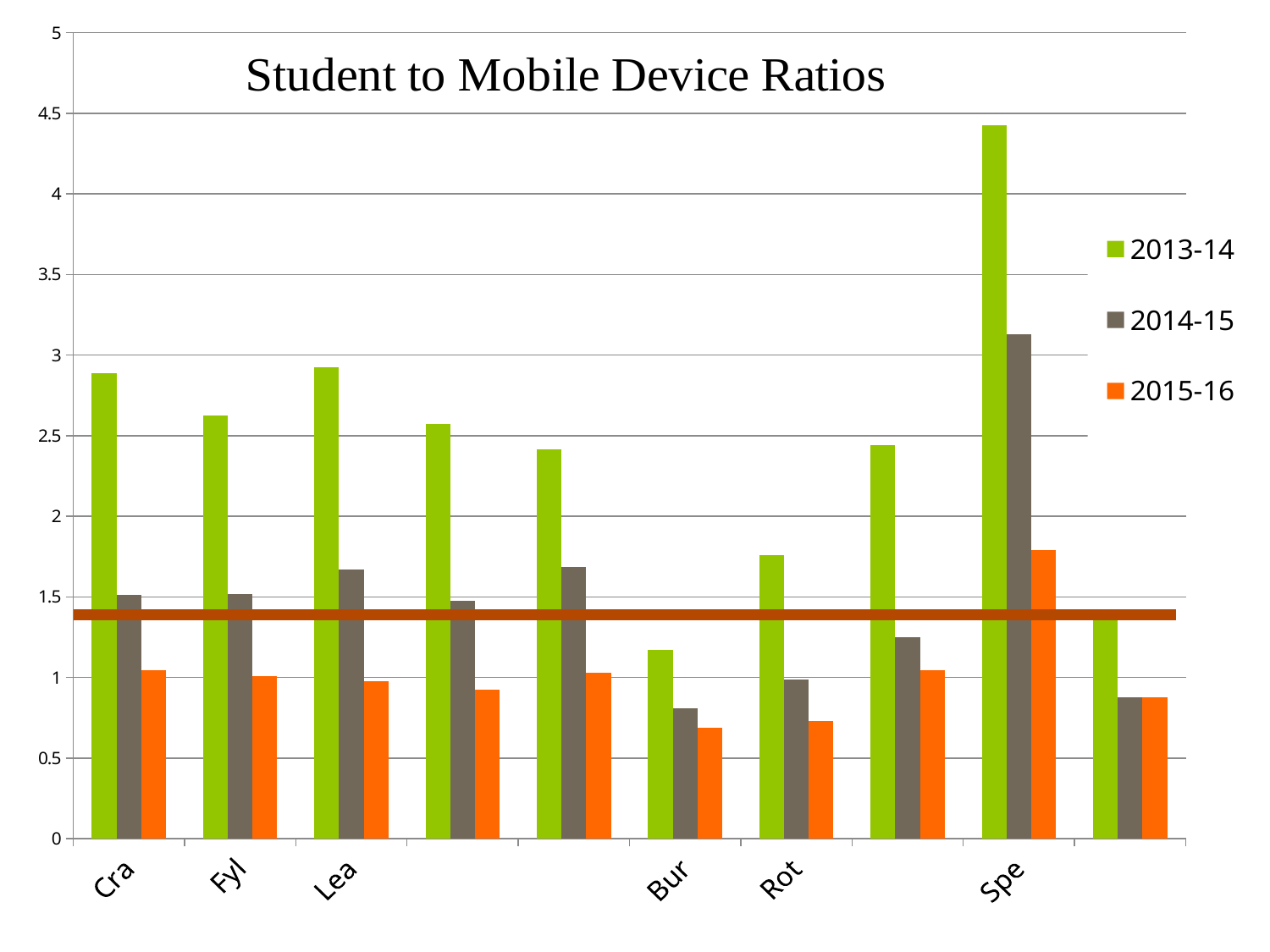
Which is larger, the 2013-14 value for Lea or the 2013-14 value for Fyl? Lea Which is larger, the 2013-14 value for Rot or the 2013-14 value for Bur? Rot Is the 2015-16 value for Spe greater or less than 1.5? greater Is the 2013-14 value for Bur greater or less than 1.5? less What is the title of the chart? Student to Mobile Device Ratios How many groups of bars are plotted along the x axis? 10 Is the 2013-14 value for Spe greater or less than 4? greater Which category has the lowest 2013-14 value? Bur What kind of chart is shown on the slide? bar chart How many series does the legend list? 3 Which category has the highest 2013-14 value? Spe For Cra, do the values rise or fall from 2013-14 to 2015-16? fall